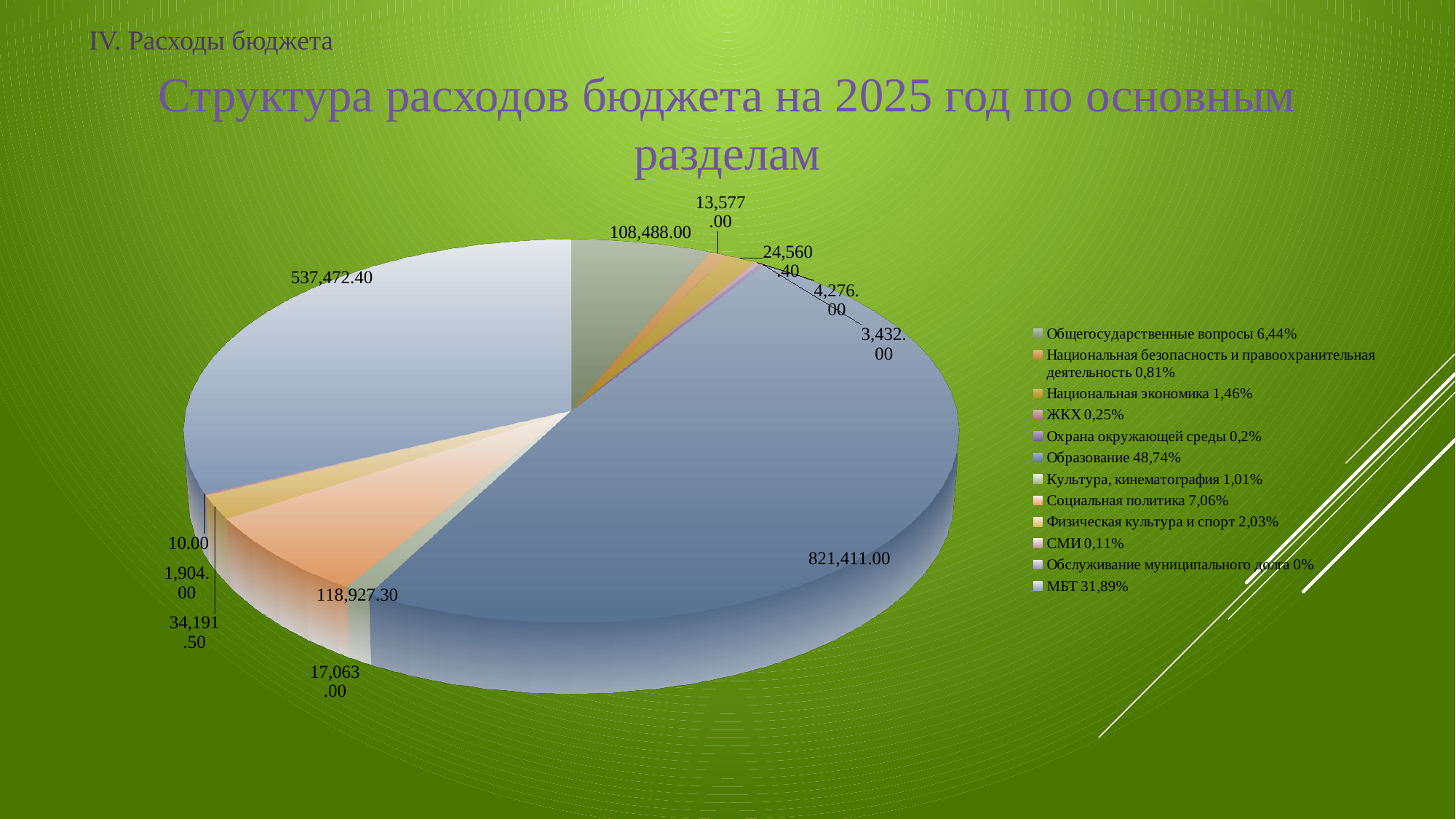
Which is larger, the Социальная политика slice or the Общегосударственные вопросы slice? Социальная политика What is the difference between the Образование value and the МБТ value? 283,938.60 What is the value of the Социальная политика slice? 118,927.30 What is the title of the chart? Структура расходов бюджета на 2025 год по основным разделам What is the value of the Общегосударственные вопросы slice? 108,488.00 Which category has the largest slice of the pie? Образование What is the value of the Образование slice? 821,411.00 Which category has the smallest slice of the pie? Обслуживание муниципального долга What share of the pie does Образование represent according to the legend? 48,74% What kind of chart is shown on the slide? Pie chart How many categories does the legend of the pie chart list? 12 What is the value of the МБТ slice? 537,472.40